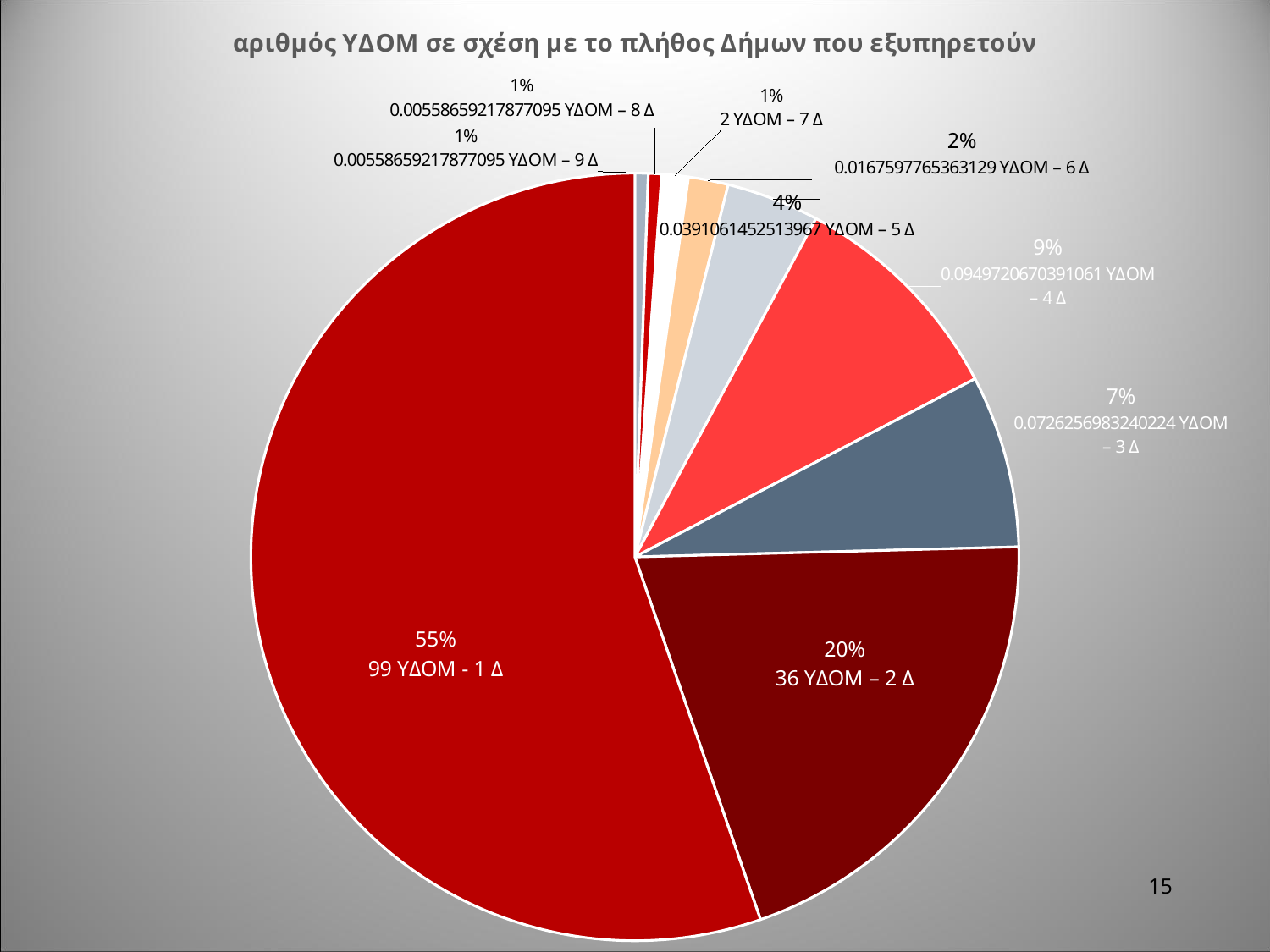
How many slices does the pie chart have? 9 What percentage share is shown for the slice for ΥΔΟΜ serving 4 Δ? 9% What kind of chart is shown on the slide? pie chart What percentage share is shown for the slice for ΥΔΟΜ serving 6 Δ? 2% What is the difference in percentage points between the share for 1 Δ and the share for 2 Δ? 35 Which is larger, the share for ΥΔΟΜ serving 3 Δ or the share for ΥΔΟΜ serving 4 Δ? 4 Δ What percentage share does the slice labelled "36 ΥΔΟΜ – 2 Δ" have? 20% What is the title of the chart? αριθμός ΥΔΟΜ σε σχέση με το πλήθος Δήμων που εξυπηρετούν Which slice has the largest share of the pie? 99 ΥΔΟΜ - 1 Δ